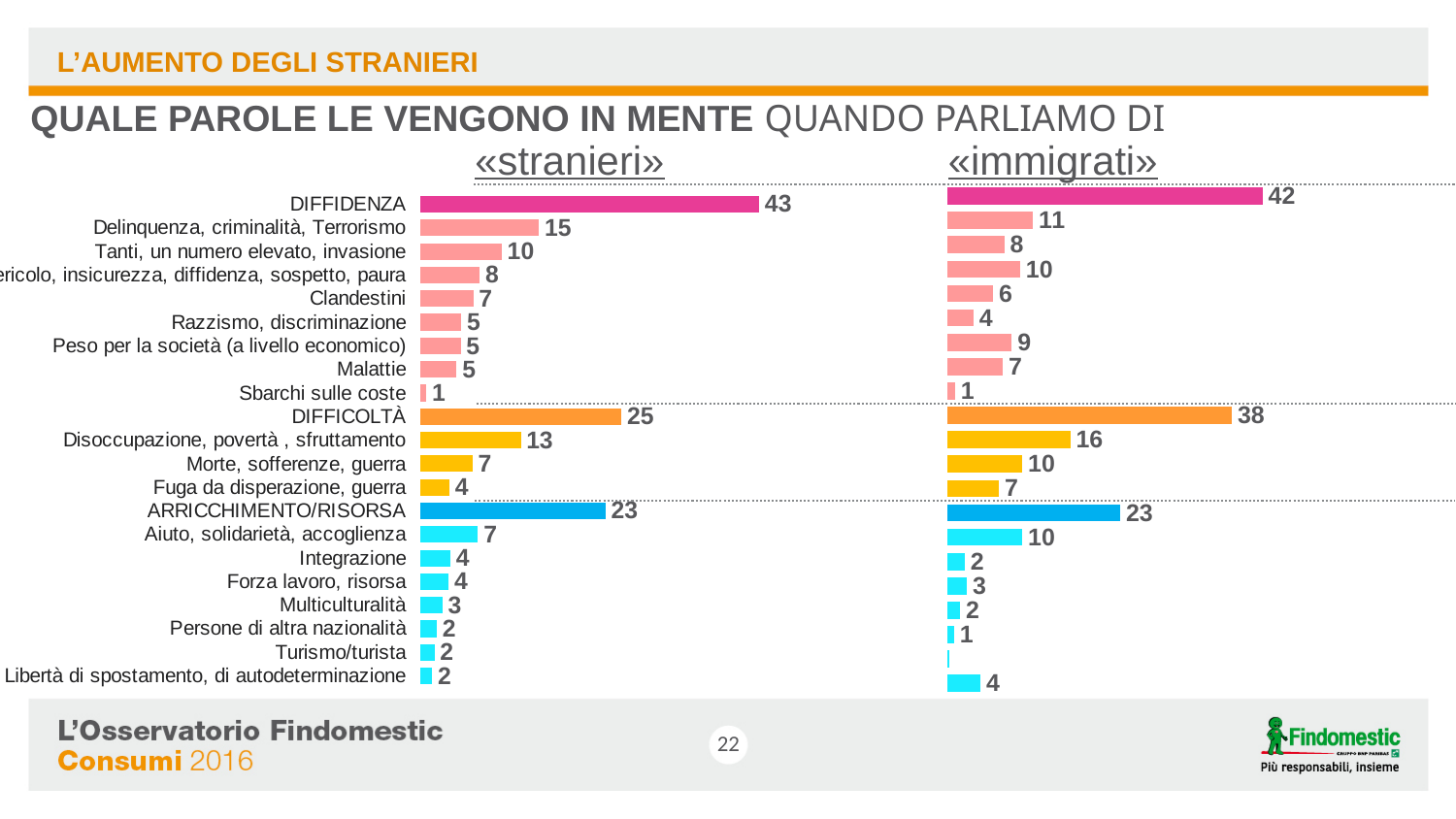
In the «immigrati» chart, what is the value for Peso per la società (a livello economico)? 9 In the «immigrati» chart, what is the value for Aiuto, solidarietà, accoglienza? 10 In the «stranieri» chart, which category has the highest value? DIFFIDENZA In the «stranieri» chart, what is the value for Disoccupazione, povertà, sfruttamento? 13 What is the value for ARRICCHIMENTO/RISORSA in the «immigrati» chart? 23 In the «immigrati» chart, what is the value for DIFFICOLTÀ? 38 In the «immigrati» chart, which category has the highest value? DIFFIDENZA Which is larger: the value for Delinquenza, criminalità, Terrorismo in the «stranieri» chart or in the «immigrati» chart? «stranieri» What is the difference between the DIFFICOLTÀ values in the «immigrati» chart and the «stranieri» chart? 13 What type of chart is used on this slide? Bar chart In the «stranieri» chart, what is the value for DIFFIDENZA? 43 In the «stranieri» chart, what is the difference between DIFFIDENZA and ARRICCHIMENTO/RISORSA? 20